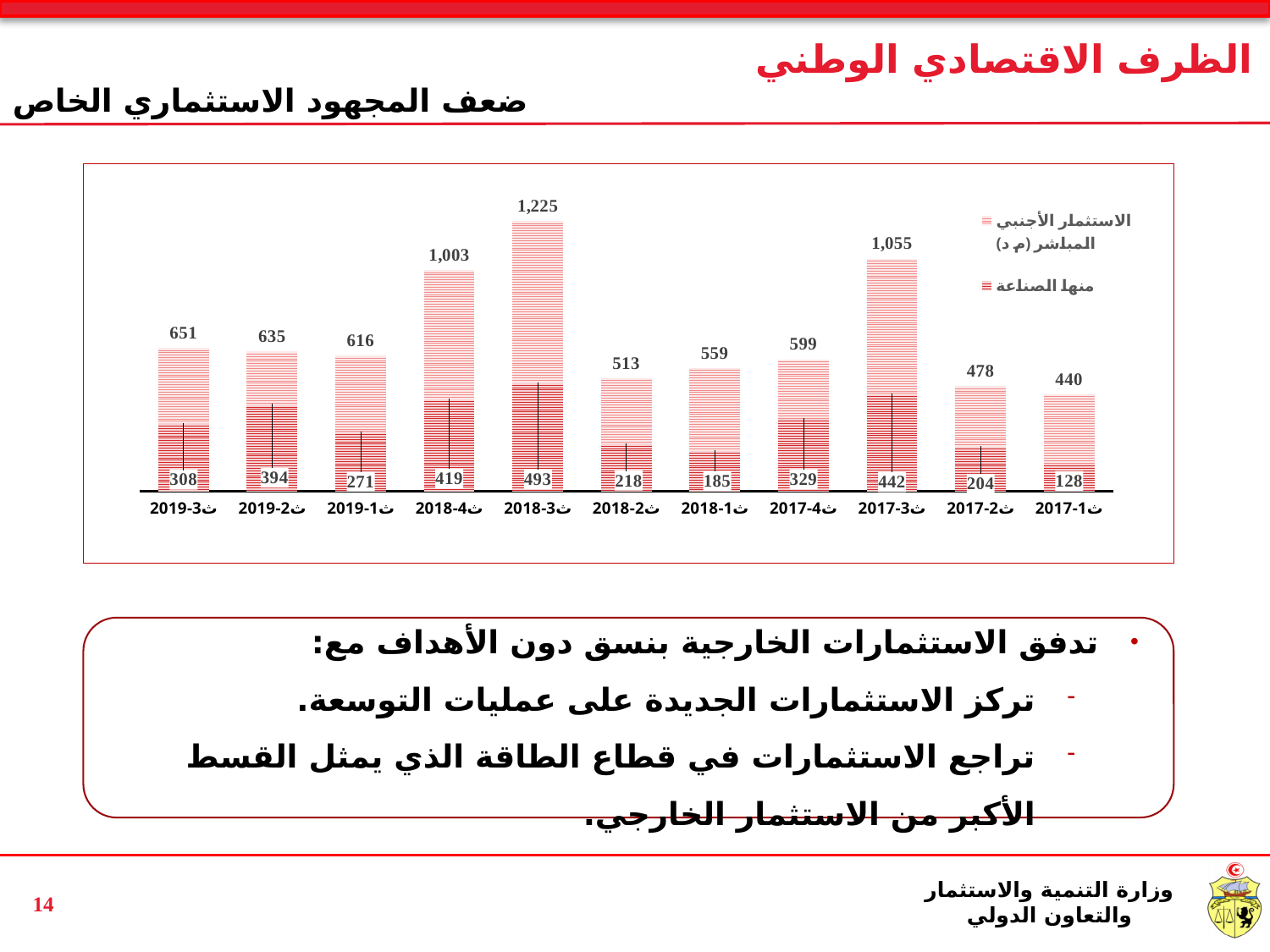
What is the value of الاستثمار الأجنبي المباشر for ث3-2019? 651 Which is larger: الاستثمار الأجنبي المباشر for ث4-2018 or for ث3-2017? ث3-2017 What unit is given in the legend for الاستثمار الأجنبي المباشر? م د How many series does the chart legend list? 2 What is the value of منها الصناعة for ث1-2017? 128 What is the value of الاستثمار الأجنبي المباشر for ث3-2018? 1,225 Which quarter has the lowest value of منها الصناعة? ث1-2017 How many quarters (categories) are shown on the x axis of the chart? 11 What is the difference in الاستثمار الأجنبي المباشر between ث2-2019 and ث1-2019? 19 What type of chart is shown on the slide? bar chart Which quarter has the highest value of الاستثمار الأجنبي المباشر? ث3-2018 What is the difference between الاستثمار الأجنبي المباشر and منها الصناعة for ث3-2017? 613